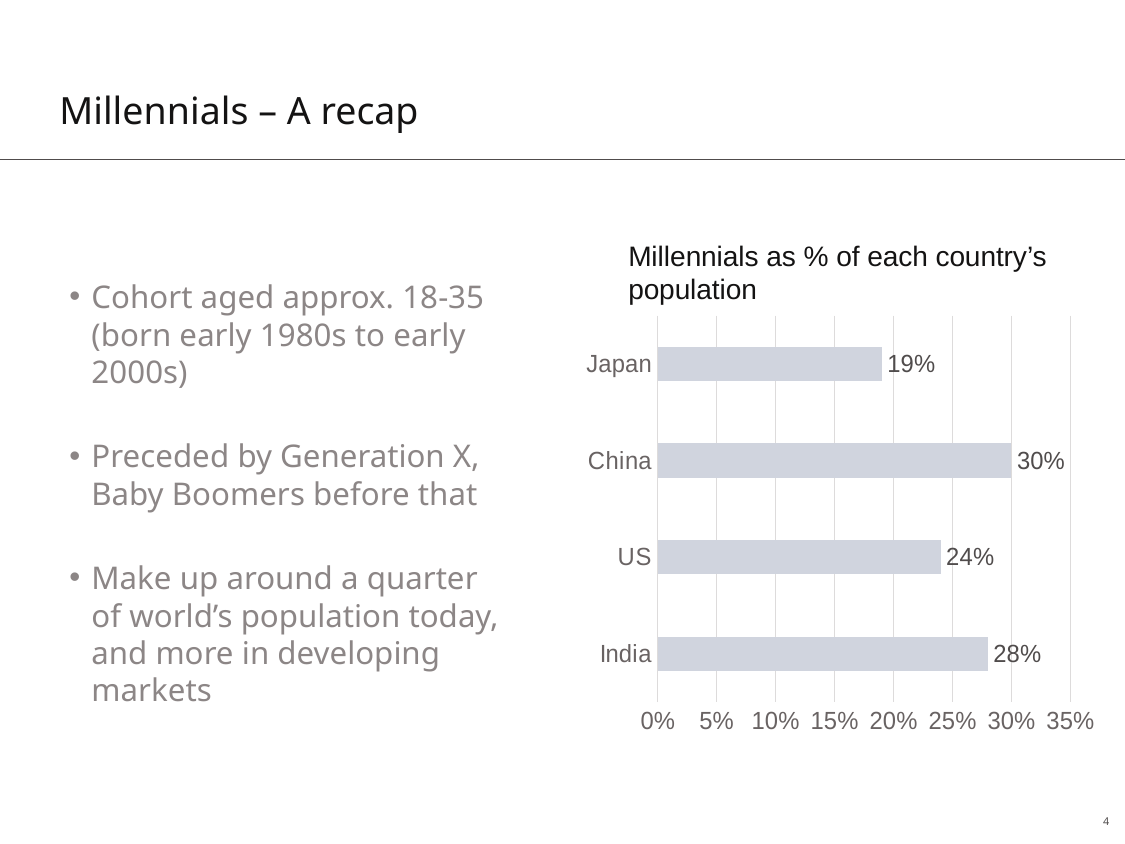
Which is larger, the value for India or the value for the US? India How many countries are shown in the chart? 4 What is the value for Japan? 19% What is the value for India? 28% What is the difference between the values for India and the US? 4% Which country has the lowest value? Japan Which country has the highest value? China What is the value for China? 30% What kind of chart is shown on the slide? Bar chart What is the difference between the values for China and Japan? 11% What is the title of the chart? Millennials as % of each country's population What is the value for the US? 24%